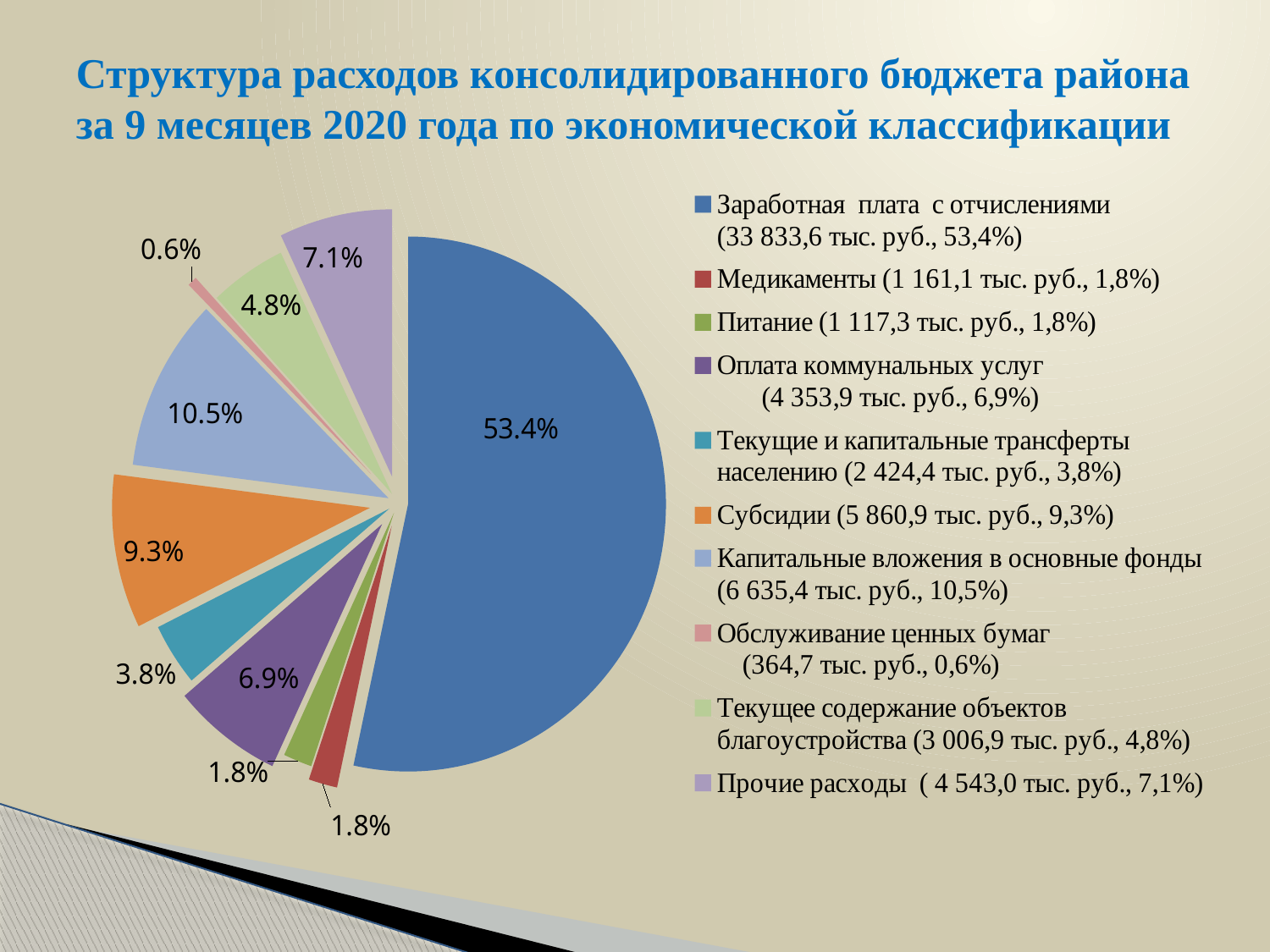
What is the difference in percentage points between the share of Заработная плата с отчислениями and the share of Капитальные вложения в основные фонды? 42.9% How many slices does the pie chart have? 10 According to the legend, what is the amount for Прочие расходы? 4 543,0 тыс. руб. Which category has the largest slice of the pie? Заработная плата с отчислениями What colour is the slice for Субсидии? orange According to the legend, what is the amount for Медикаменты? 1 161,1 тыс. руб. What share of the pie does Капитальные вложения в основные фонды represent? 10.5% According to the legend, what is the amount for Текущие и капитальные трансферты населению? 2 424,4 тыс. руб. Which category has the smallest slice of the pie? Обслуживание ценных бумаг Which slice is larger: Субсидии or Оплата коммунальных услуг? Субсидии What kind of chart is shown on the slide? pie chart What share of the pie does Субсидии represent? 9.3%